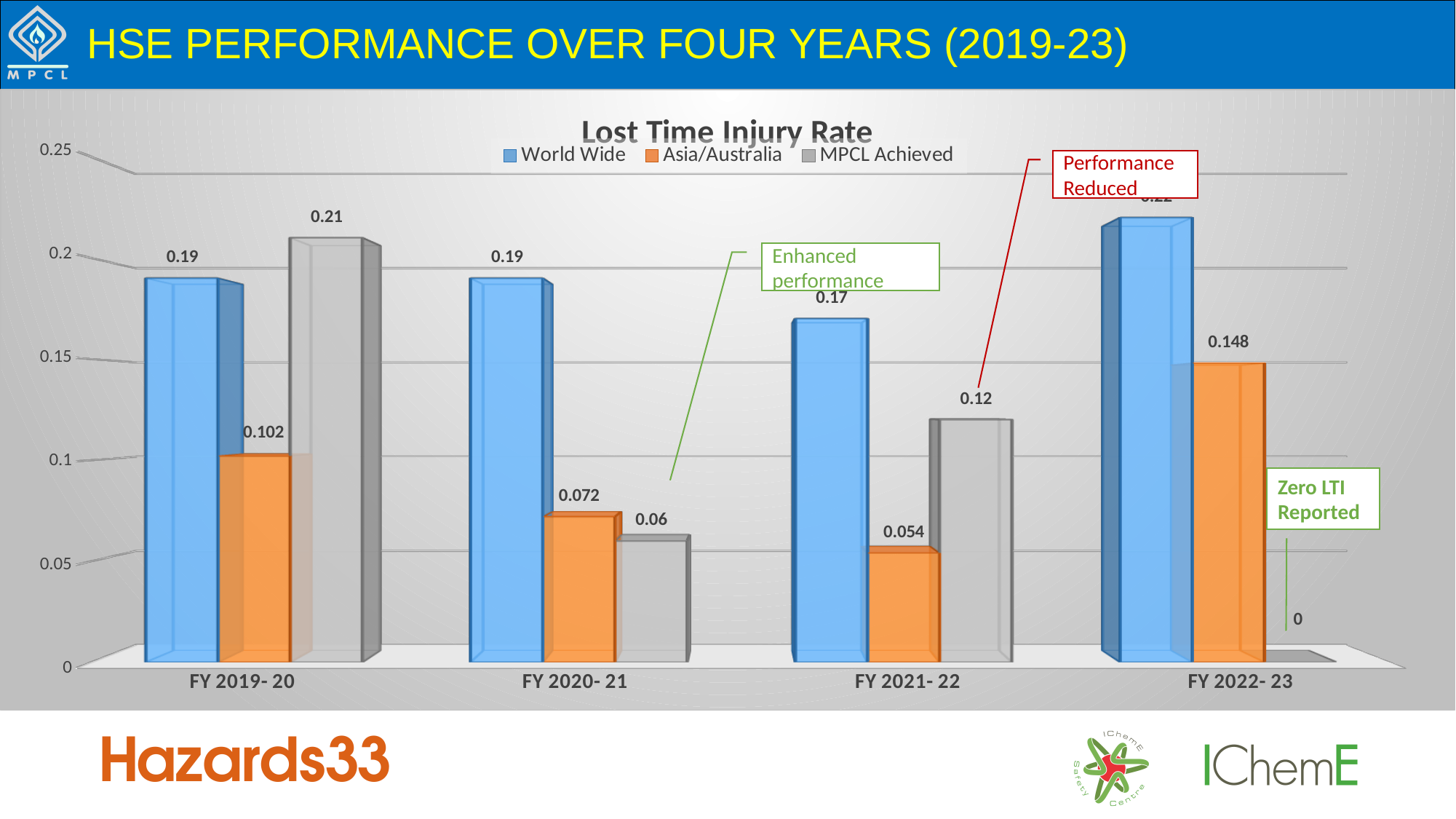
In which fiscal year is the Asia/Australia value highest? FY 2022- 23 How many series does the chart legend list? 3 What is the title of the chart? Lost Time Injury Rate How many fiscal year categories are shown on the x axis? 4 What is the MPCL Achieved value for FY 2019-20? 0.21 What is the MPCL Achieved value for FY 2022-23? 0 Is the World Wide value for FY 2022-23 greater or less than 0.2? greater Which is larger for FY 2021-22, the Asia/Australia value or the MPCL Achieved value? MPCL Achieved In which fiscal year is the MPCL Achieved value lowest? FY 2022- 23 What kind of chart is shown on the slide? bar chart What is the difference between the World Wide and MPCL Achieved values for FY 2020-21? 0.13 What is the Asia/Australia value for FY 2021-22? 0.054